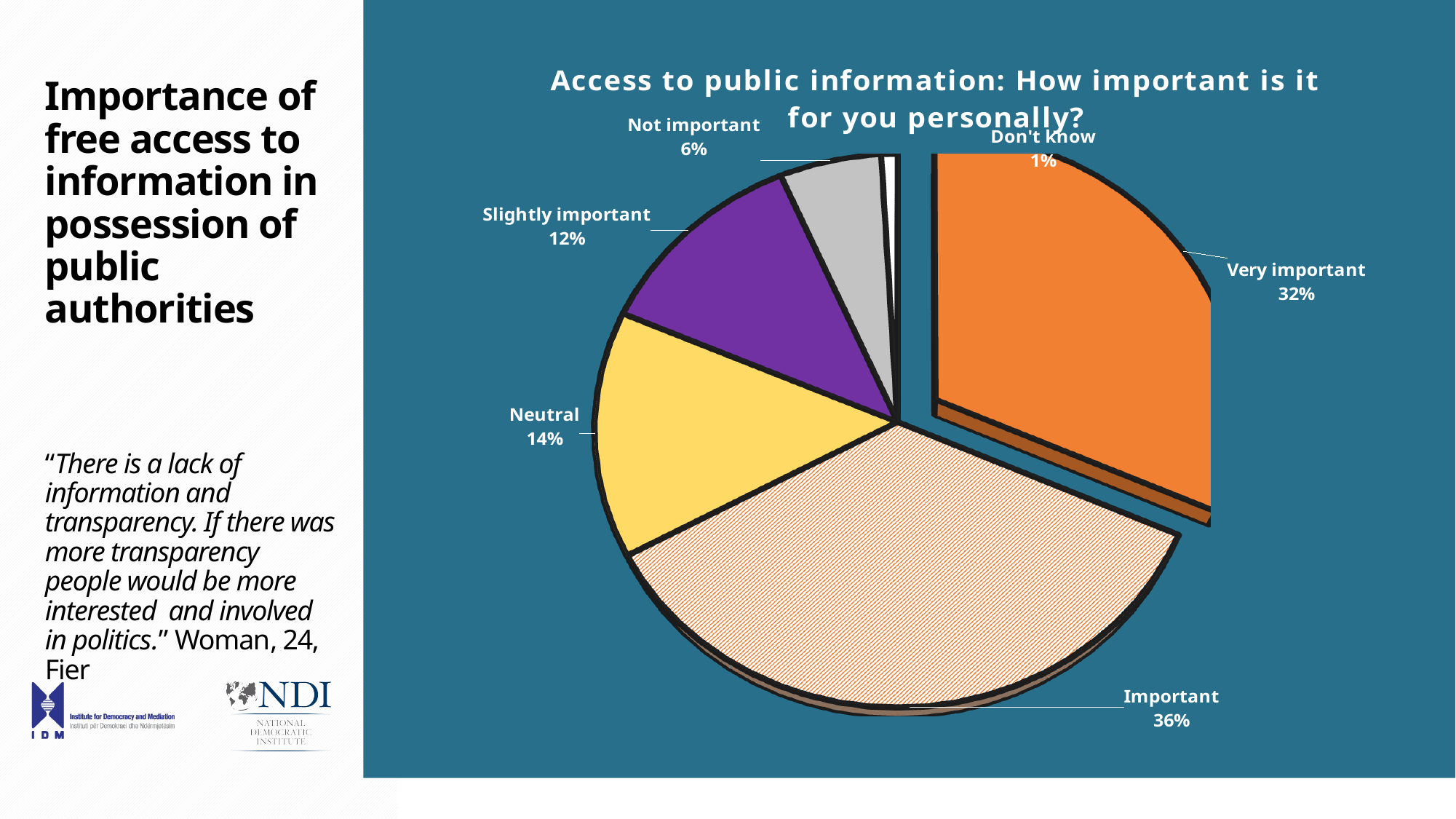
Which is larger, the share for Neutral or the share for Slightly important? Neutral Which category has the smallest slice of the pie? Don't know What type of chart is shown on the slide? Pie chart What is the title of the chart? Access to public information: How important is it for you personally? Which category has the largest slice of the pie? Important What is the difference in percentage points between Important and Very important? 4 What share of the pie is labelled Neutral? 14% What is the combined share of Important and Very important? 68% How many categories are shown in the pie chart? 6 What percentage of respondents said access to public information is very important for them personally? 32% What percentage is shown for Slightly important? 12% What percentage is shown for Not important? 6%